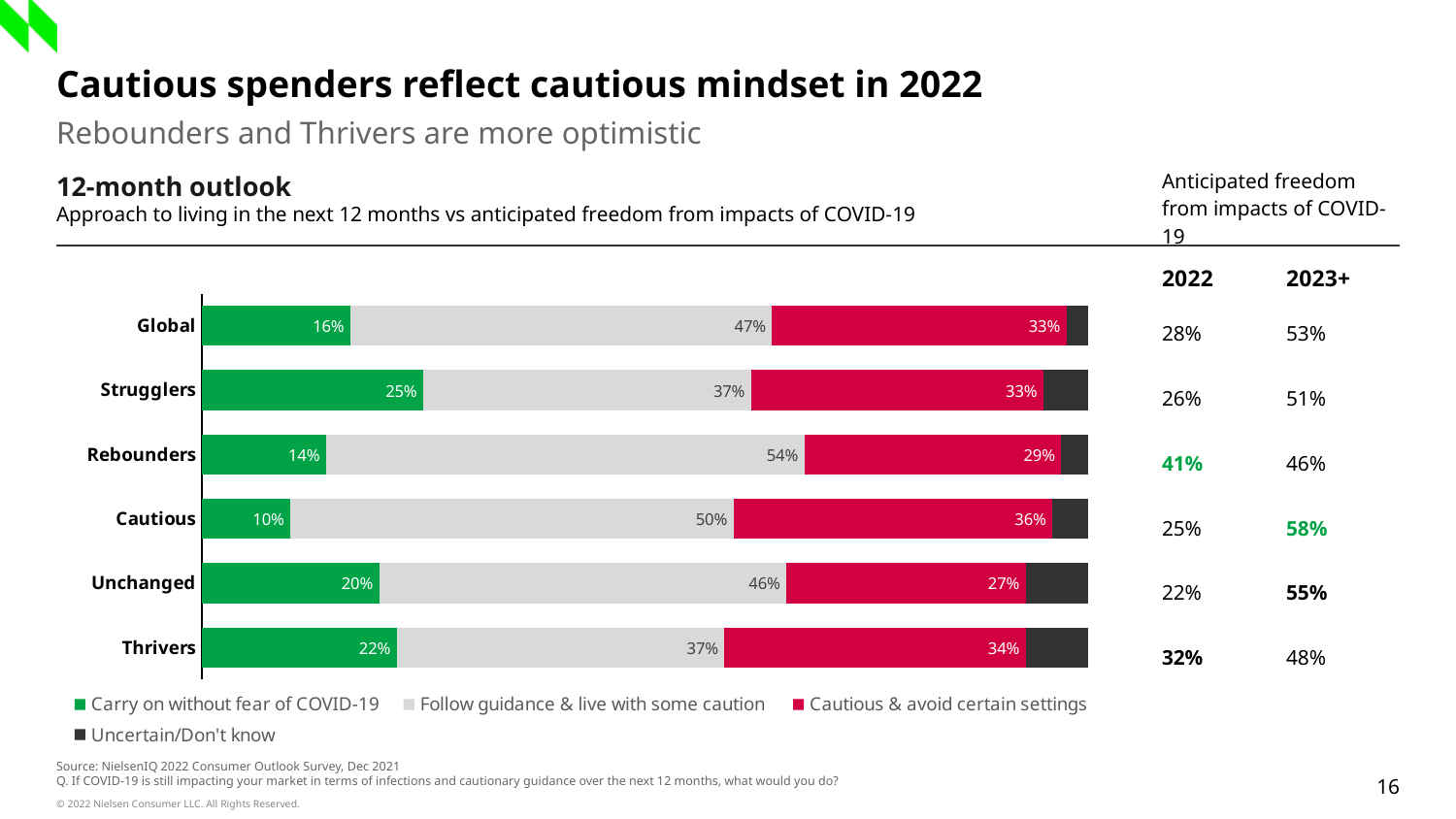
What is the value for 'Cautious & avoid certain settings' for Cautious? 36% What is the difference between the 'Follow guidance & live with some caution' values for Rebounders and Thrivers? 17% How many categories are plotted on the chart? 6 What is the value for 'Carry on without fear of COVID-19' for Strugglers? 25% Which is larger: the 'Carry on without fear of COVID-19' value for Thrivers or for Unchanged? Thrivers Which category has the lowest value for 'Cautious & avoid certain settings'? Unchanged Which category has the highest value for 'Carry on without fear of COVID-19'? Strugglers What is the value for 'Follow guidance & live with some caution' for Rebounders? 54% Which legend entry is shown in green? Carry on without fear of COVID-19 Which category has the lowest value for 'Carry on without fear of COVID-19'? Cautious How many series does the chart legend list? 4 What kind of chart is shown on the slide? Stacked bar chart